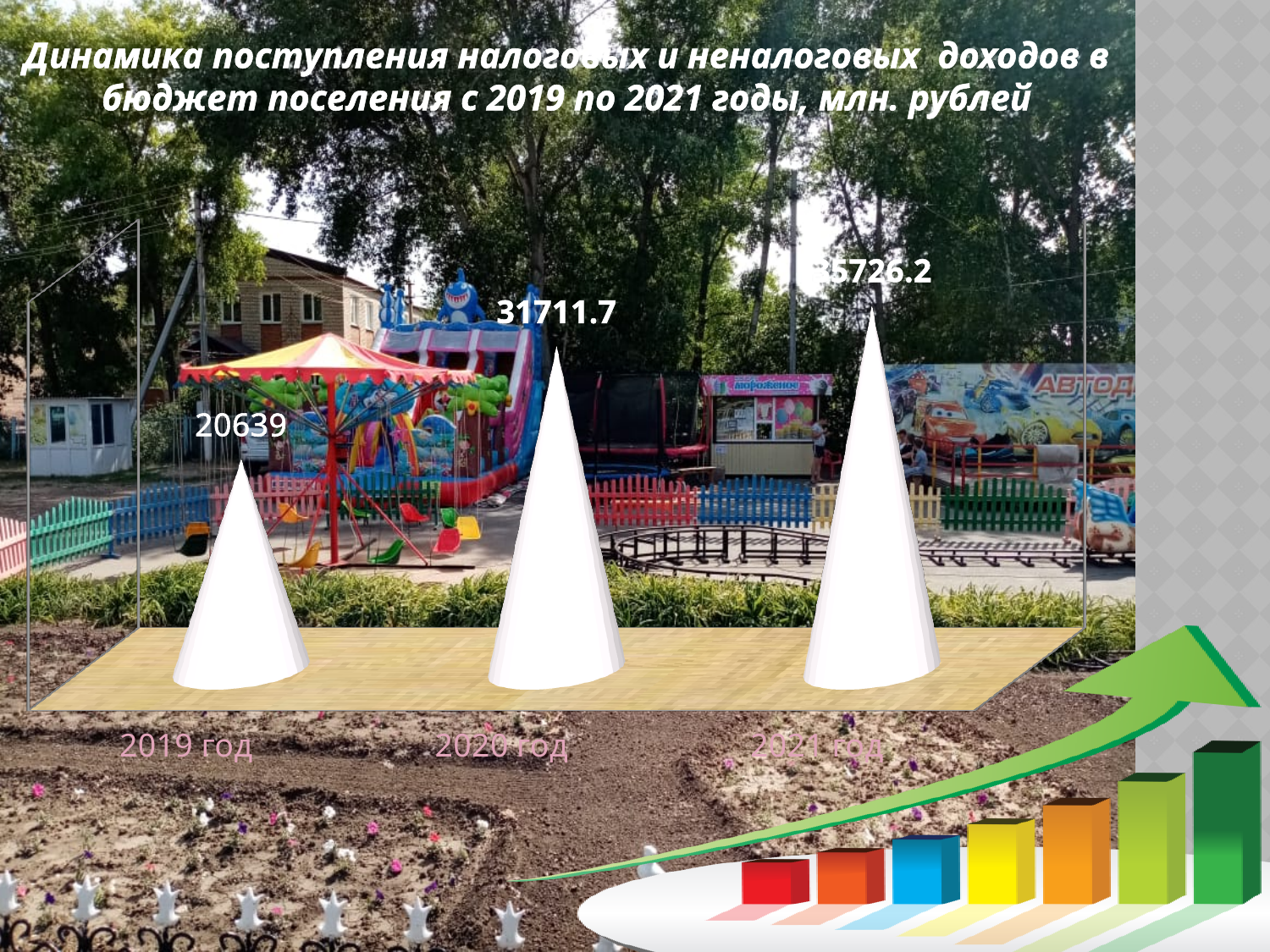
What is the value shown for 2019 год? 20639 Which year has the lowest value? 2019 год What is the difference between the values for 2021 год and 2019 год? 15087.2 How many years (categories) are plotted on the chart? 3 What is the value shown for 2020 год? 31711.7 What is the difference between the values for 2020 год and 2019 год? 11072.7 Do the values rise or fall from 2019 to 2021? rise Which year has the highest value? 2021 год What unit of measurement is stated in the chart title? млн. рублей Which is larger, the value for 2020 год or the value for 2019 год? 2020 год What is the value shown for 2021 год? 35726.2 What is the difference between the values for 2021 год and 2020 год? 4014.5